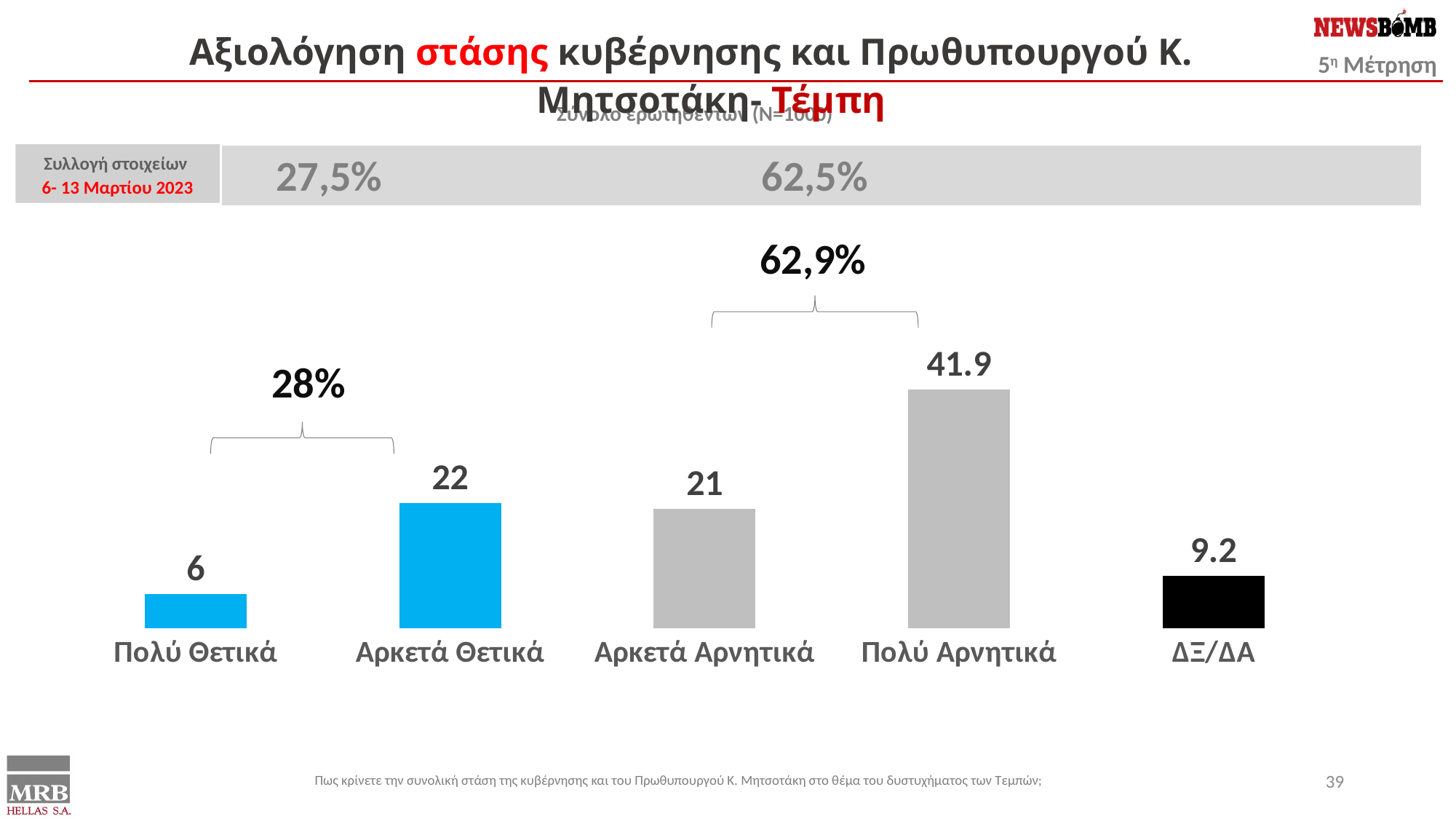
What is the value for Πολύ Αρνητικά? 41.9 What is the value for Πολύ Θετικά? 6 Which is larger, the value for Αρκετά Θετικά or the value for ΔΞ/ΔΑ? Αρκετά Θετικά What combined percentage is shown by the bracket over Αρκετά Αρνητικά and Πολύ Αρνητικά? 62,9% How many categories are shown in the bar chart? 5 What kind of chart is shown on the slide? Bar chart Which category has the lowest value? Πολύ Θετικά What is the difference between the values for Πολύ Αρνητικά and Αρκετά Αρνητικά? 20.9 What is the value for ΔΞ/ΔΑ? 9.2 What is the value for Αρκετά Θετικά? 22 What combined percentage is shown by the bracket over Πολύ Θετικά and Αρκετά Θετικά? 28% Which category has the highest value? Πολύ Αρνητικά